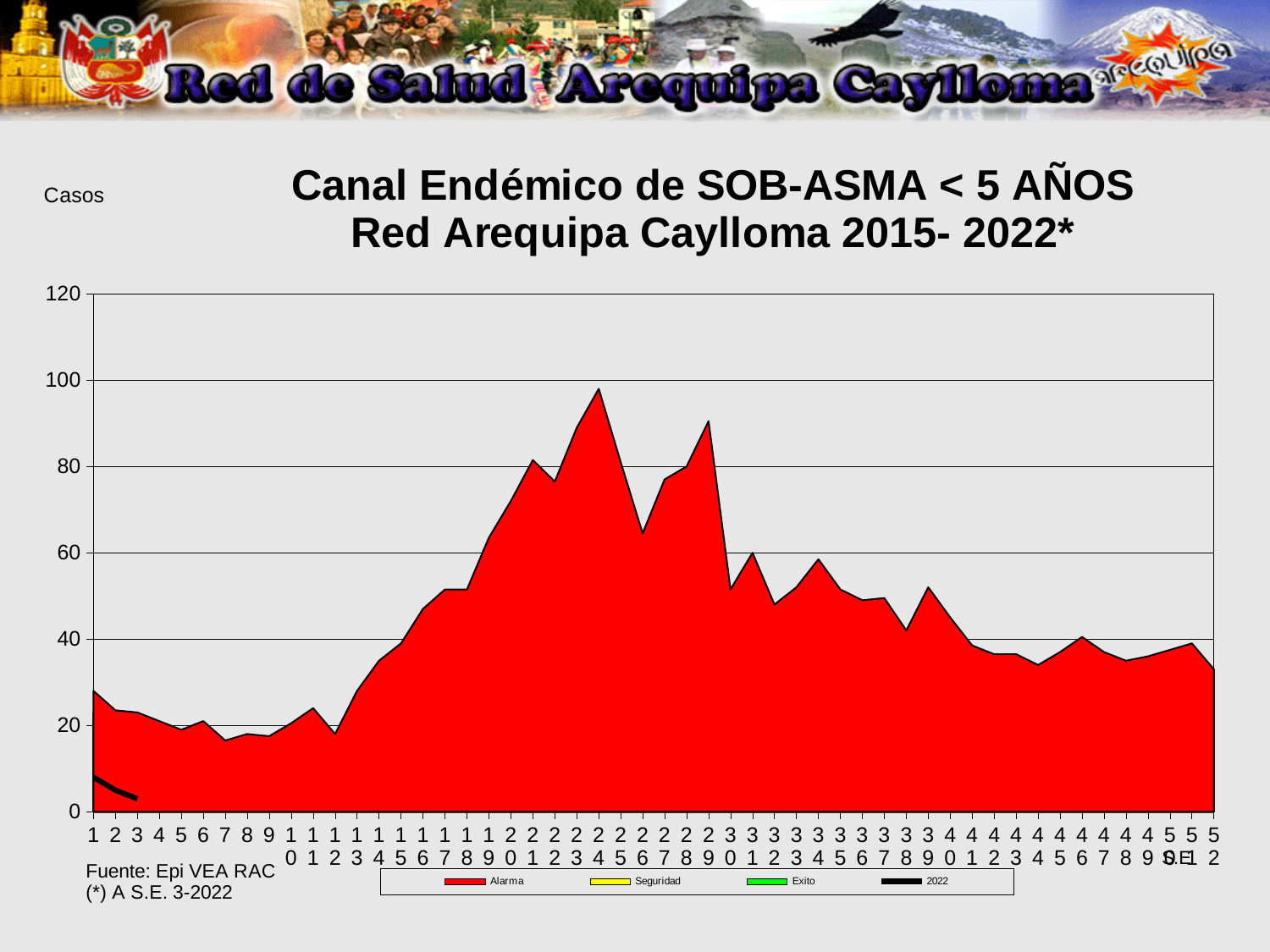
What kind of chart is shown on the slide? area chart Is the Alarma value at week 52 greater or less than 40? less How many epidemiological weeks are plotted along the x axis? 52 Is the Alarma value at week 24 greater or less than 80? greater Which is larger, the Alarma value at week 24 or at week 29? week 24 What colour represents the Alarma series in the legend? red Does the Alarma curve rise or fall between week 12 and week 24? rise Is the Alarma value at week 33 greater or less than 60? less How many series does the legend list? 4 At which week does the Alarma curve reach its highest value? 24